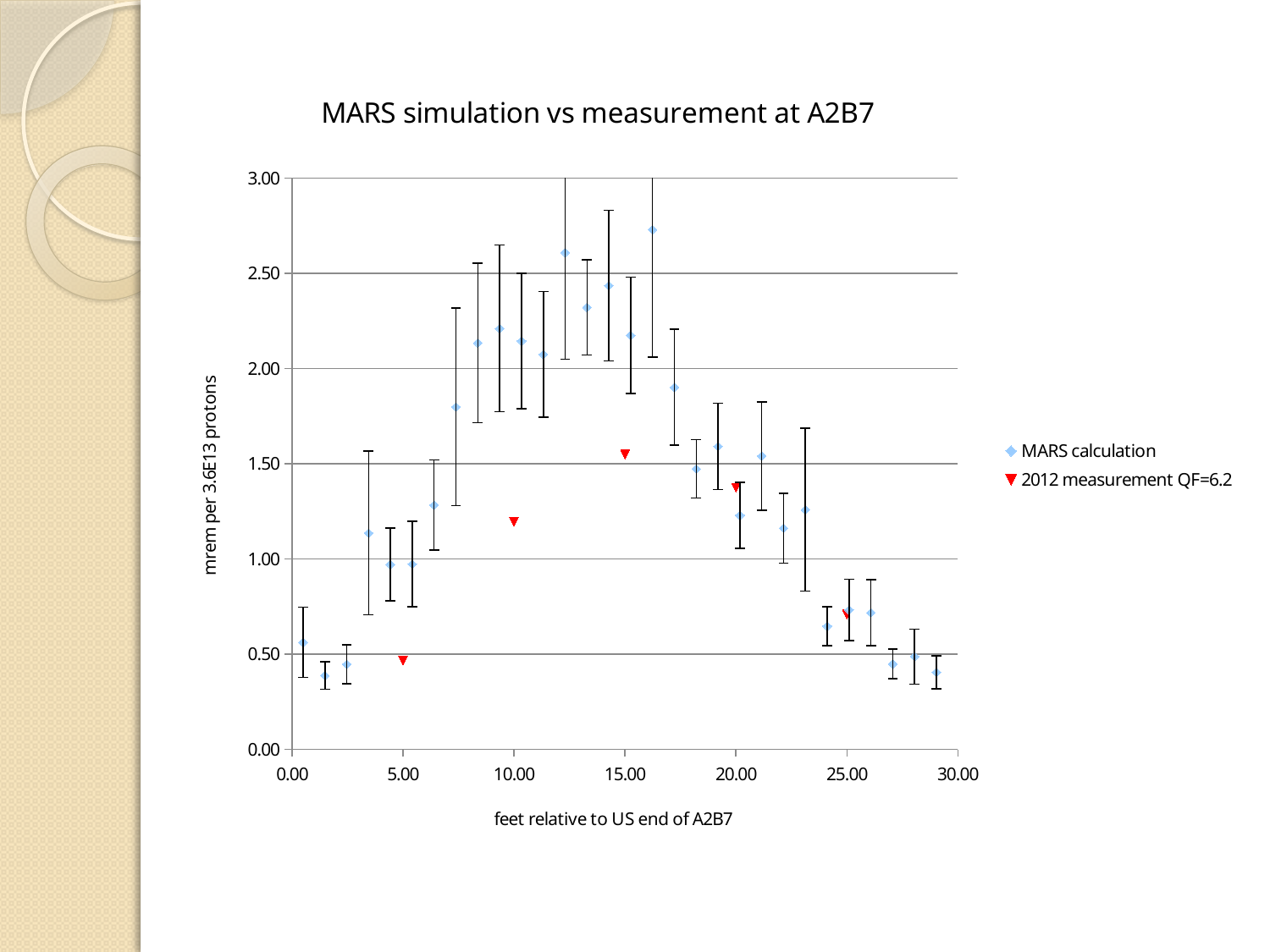
Is the 2012 measurement value at 20.00 feet greater or less than 1.50? less What is the label of the y axis? mrem per 3.6E13 protons Is the MARS calculation value at about 12.50 feet greater or less than 2.50? greater What kind of chart is shown on the slide? scatter chart How many series does the legend list? 2 At 10.00 feet, which is larger: the MARS calculation or the 2012 measurement? MARS calculation What is the title of the chart? MARS simulation vs measurement at A2B7 At which x position does the 2012 measurement series reach its highest value? 15.00 Is the 2012 measurement value at 25.00 feet greater or less than 0.50? greater How many 2012 measurement points (red triangles) are plotted? 5 How do the MARS calculation values change as the distance increases from 0 to 30 feet? rise then fall